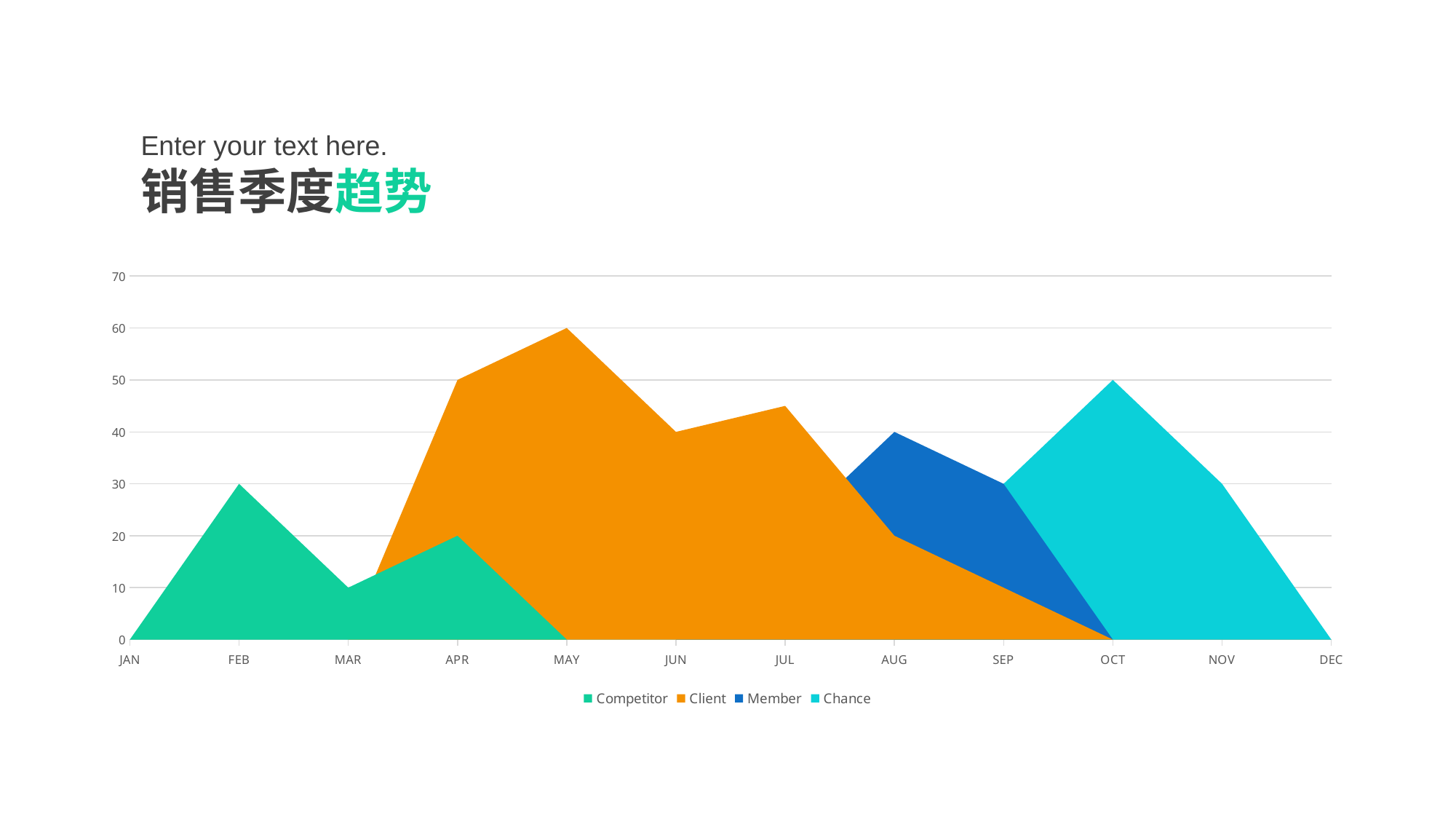
Which series is shown in orange in the legend? Client What is the difference between the Client value in MAY and the Client value in JUN? 20 What is the value of the Client series in MAY? 60 What is the value of the Competitor series in FEB? 30 Which is larger: the Competitor value in FEB or the Competitor value in APR? FEB In which month does the Client series reach its highest value? MAY What is the value of the Member series in AUG? 40 How many months are shown on the x axis? 12 What is the value of the Chance series in OCT? 50 Is the value of the Client series in JUL greater or less than 40? greater What type of chart is shown on the slide? area chart How many series does the legend list? 4